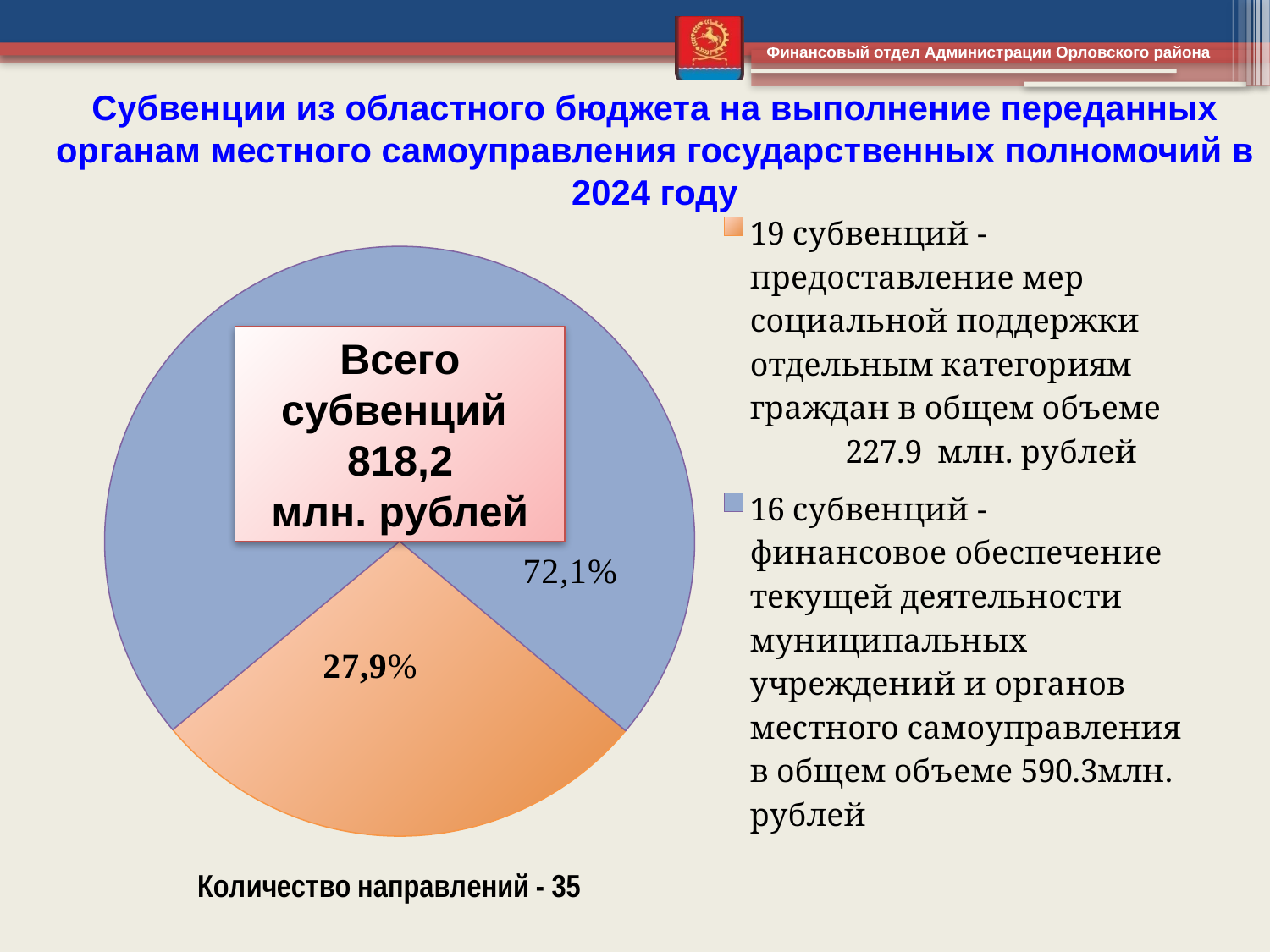
What kind of chart is shown on the slide? pie chart How many directions (направлений) are stated below the pie chart? 35 Which is larger: the share for social support measures (19 subventions) or the share for financial support of municipal institutions (16 subventions)? financial support of municipal institutions (16 subventions), 72,1% By how many percentage points does the blue slice (72,1%) exceed the orange slice (27,9%)? 44,2 percentage points What is the total amount for the 19 subventions providing social support measures, according to the legend text? 227.9 млн. рублей Which slice of the pie is the largest? the blue slice (16 subventions, financial support of municipal institutions), 72,1% How many slices does the pie chart have? 2 Which slice of the pie is the smallest? the orange slice (19 subventions, social support measures), 27,9% What is the total amount for the 16 subventions for financial support of municipal institutions, according to the legend text? 590.3 млн. рублей What is the total amount of subventions shown in the centre of the pie chart? 818,2 млн. рублей What share of the pie does the blue slice (16 subventions, financial support of municipal institutions and local government bodies) represent? 72,1% What share of the pie does the orange slice (19 subventions, social support measures for certain categories of citizens) represent? 27,9%